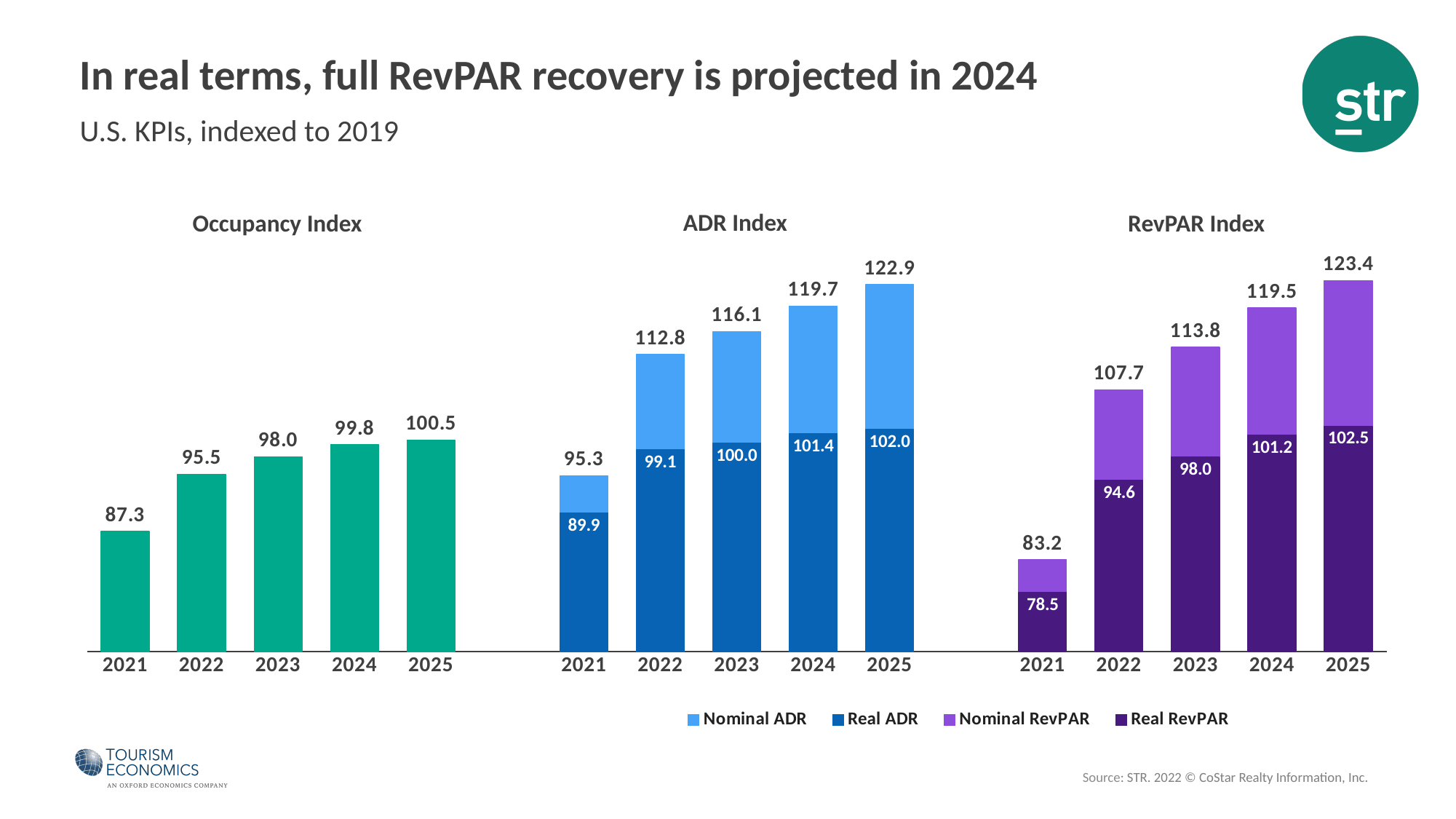
In the RevPAR Index chart, what is the Nominal RevPAR value for 2024? 119.5 How many years are shown on the x axis of the Occupancy Index chart? 5 In the ADR Index chart, what is the Nominal ADR value for 2025? 122.9 In the RevPAR Index chart, do the Real RevPAR values rise or fall from 2021 to 2025? rise In the Occupancy Index chart, which year has the highest value? 2025 In the Occupancy Index chart, what is the difference between the 2025 and 2021 values? 13.2 In the ADR Index chart, what is the Real ADR value for 2023? 100.0 In the RevPAR Index chart, which is larger: the Nominal RevPAR for 2023 or the Nominal RevPAR for 2022? 2023 In the Occupancy Index chart, what is the value for 2021? 87.3 In the RevPAR Index chart, what is the Real RevPAR value for 2022? 94.6 How many series does the legend at the bottom of the slide list? 4 In the ADR Index chart, which year has the lowest Real ADR value? 2021